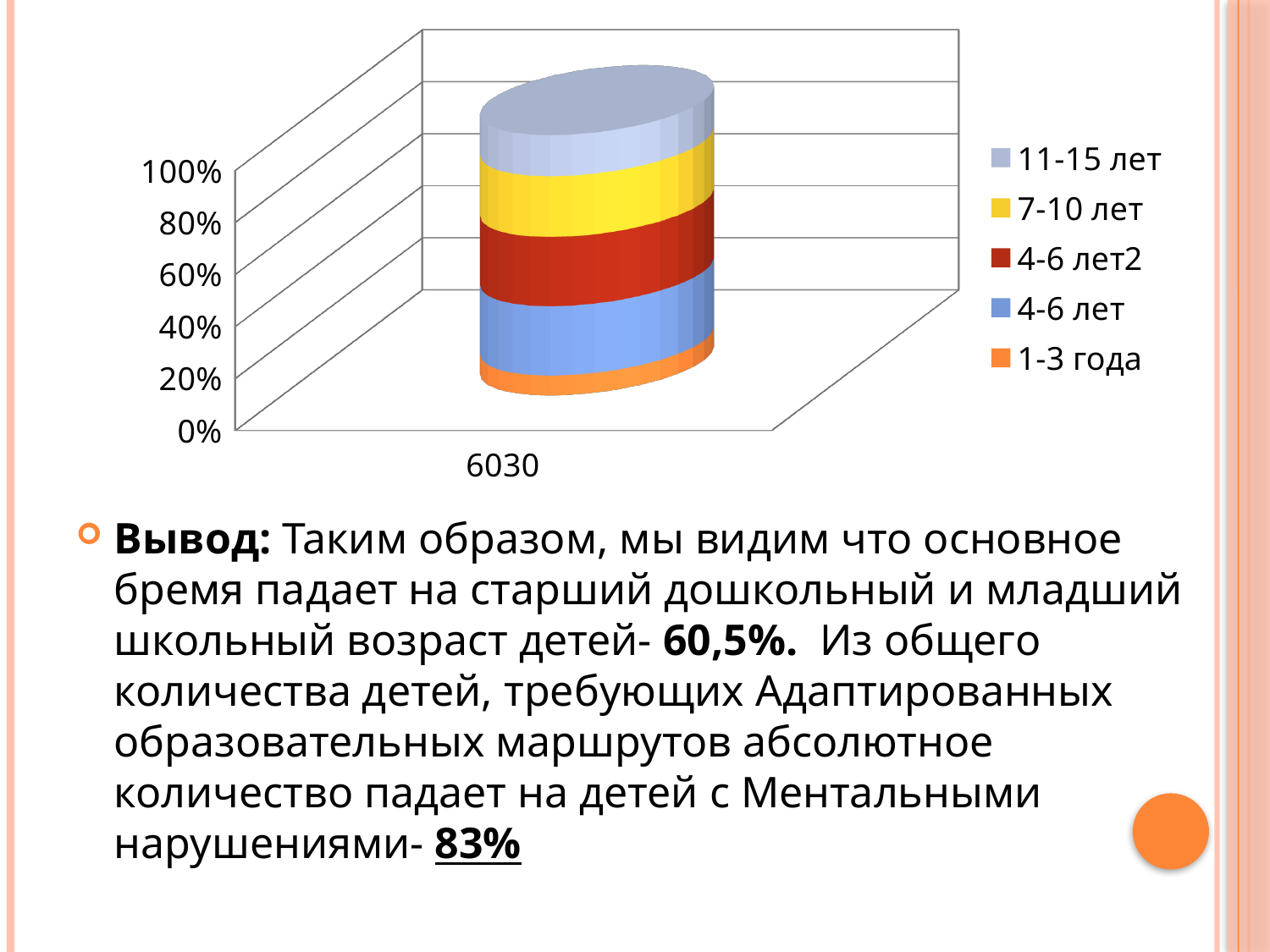
What kind of chart is shown on the slide? Stacked bar chart What is the label of the single category on the x axis? 6030 Which series is shown at the top of the stacked bar? 11-15 лет How many series does the chart legend list? 5 Which series is shown at the bottom of the stacked bar? 1-3 года What is the highest value shown on the vertical axis of the chart? 100% Is the share for 1-3 года greater or less than 20%? less Which segment is larger in the stacked bar: 1-3 года or 4-6 лет? 4-6 лет How many categories are plotted on the x axis of the chart? 1 Which series has the smallest segment in the stacked bar? 1-3 года